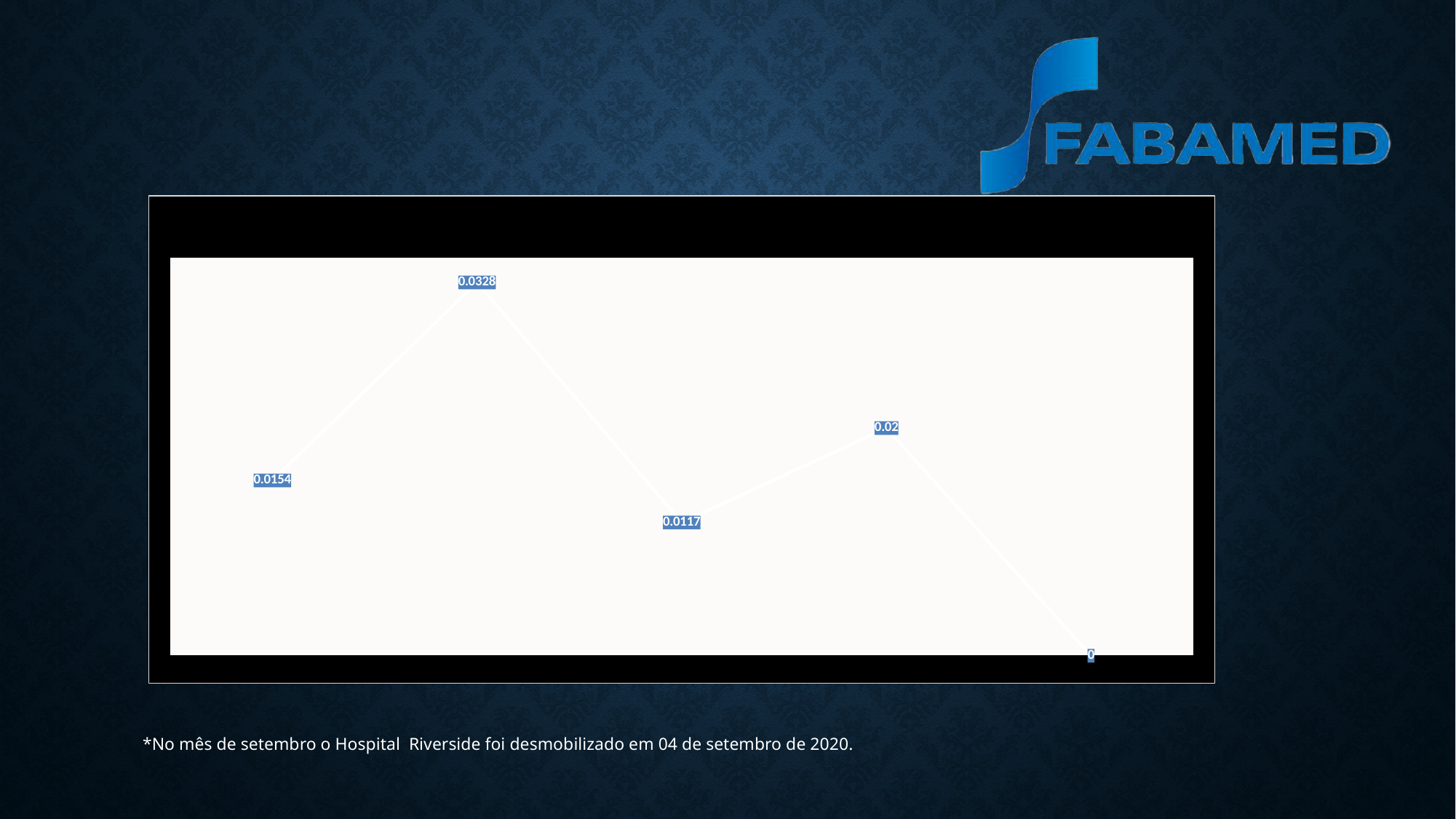
What is the difference between the second data point (0.0328) and the first data point (0.0154) on the line chart? 0.0174 What is the lowest value shown on the line chart? 0 What kind of chart is shown on the slide? line chart Which is larger on the line chart: the fourth data point or the third data point? the fourth data point (0.02) What is the value of the fourth data point from the left on the line chart? 0.02 Does the line rise or fall between the fourth and the fifth data point? fall What is the value of the third data point from the left on the line chart? 0.0117 What is the highest value shown on the line chart? 0.0328 How many data points are plotted on the line chart? 5 What is the value of the first (leftmost) data point on the line chart? 0.0154 What is the value of the last (rightmost) data point on the line chart? 0 What is the value of the second data point from the left on the line chart? 0.0328